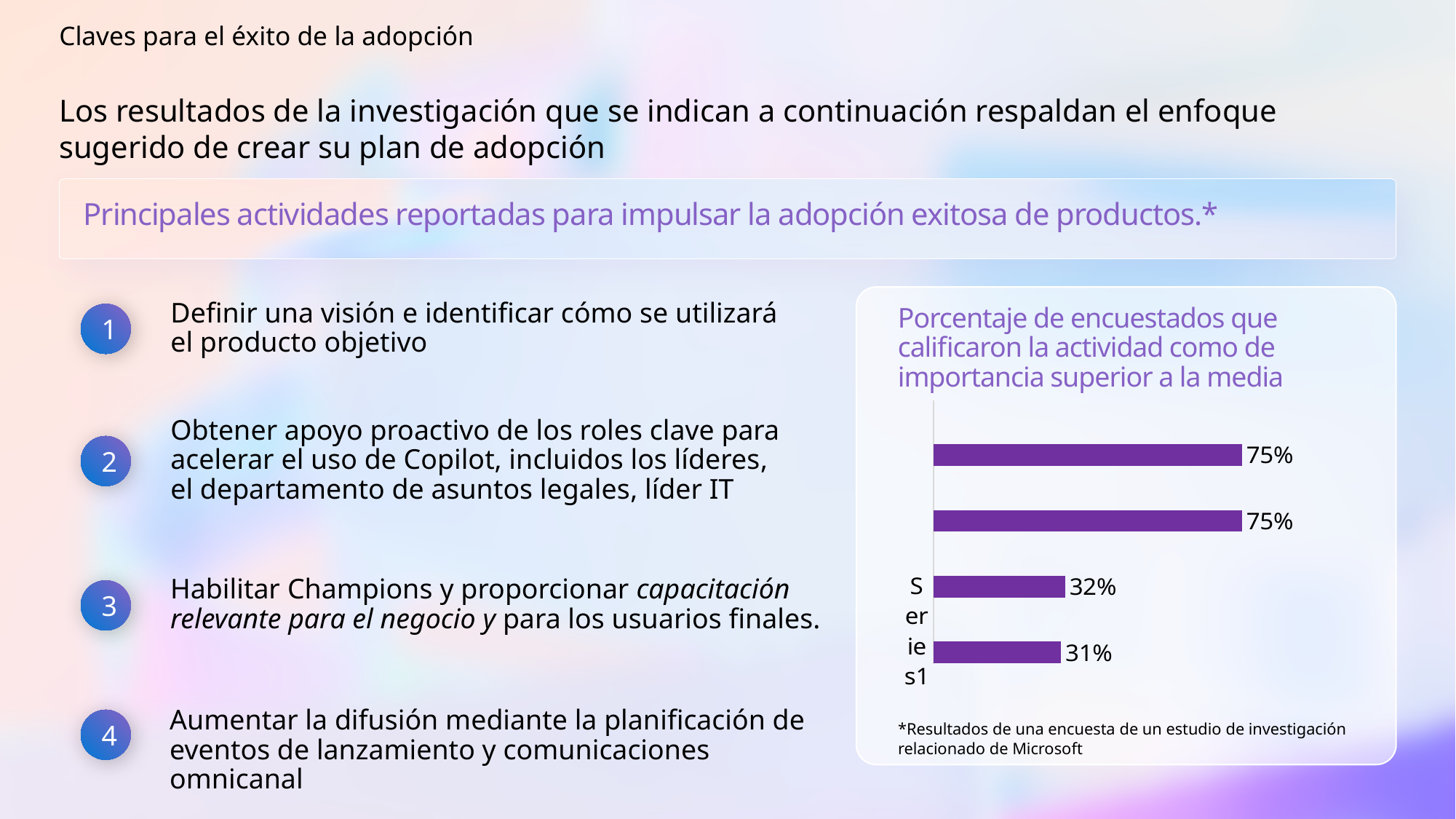
How many bars are plotted in the chart? 4 What is the value shown on the bottom bar of the chart? 31% What is the value shown on the top bar of the chart? 75% What is the title of the chart? Porcentaje de encuestados que calificaron la actividad como de importancia superior a la media What is the value shown on the third bar from the top of the chart? 32% What is the highest value shown in the chart? 75% What is the difference between the third bar's value and the bottom bar's value? 1% What is the difference between the top bar's value and the bottom bar's value? 44% What kind of chart is shown on the slide? bar chart Which is larger, the value of the top bar or the value of the third bar from the top? the top bar What is the lowest value shown in the chart? 31% What is the value shown on the second bar from the top of the chart? 75%